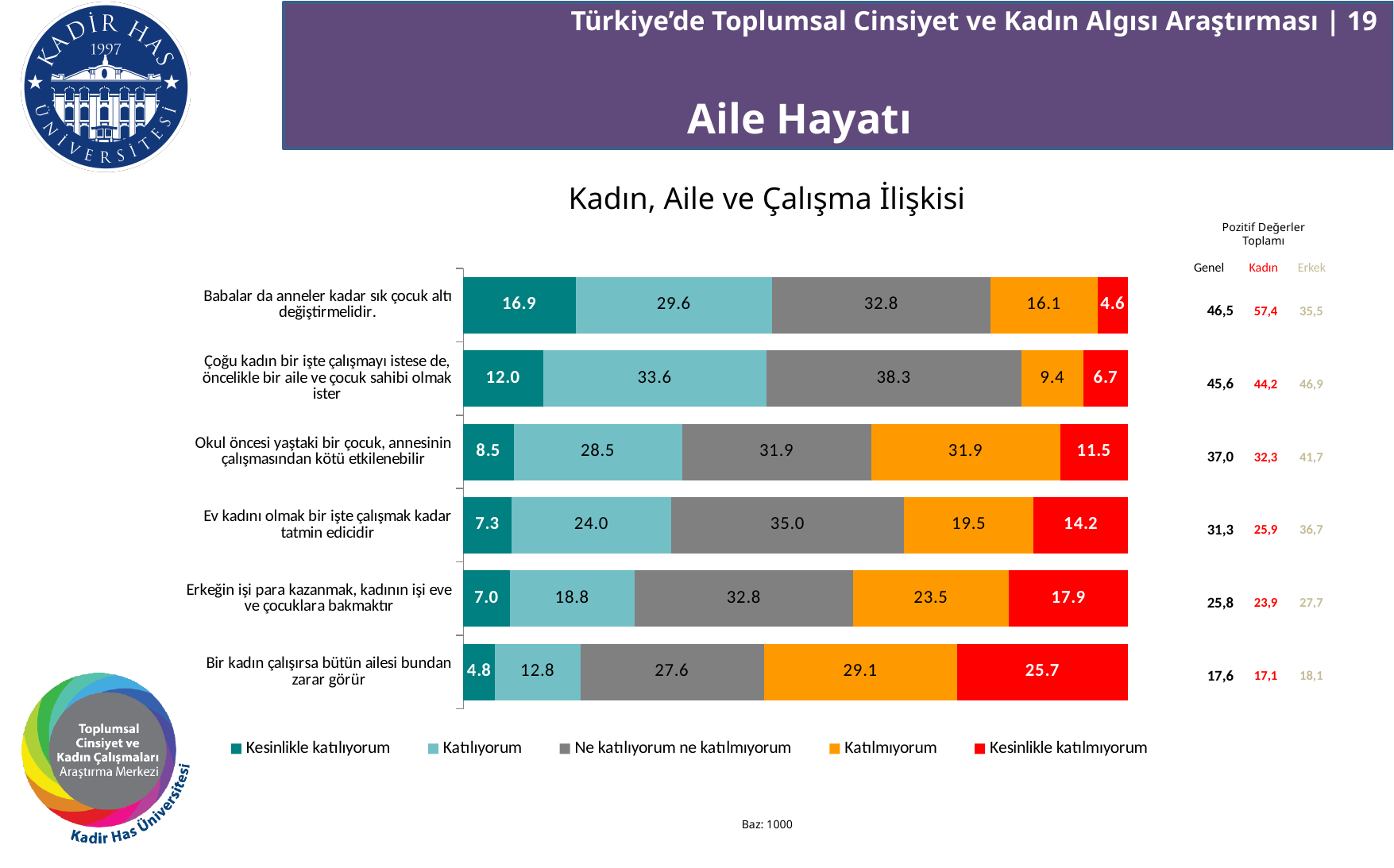
What is the 'Kesinlikle katılıyorum' value for 'Babalar da anneler kadar sık çocuk altı değiştirmelidir.'? 16.9 Which is larger: the 'Katılıyorum' value for 'Ev kadını olmak bir işte çalışmak kadar tatmin edicidir' or for 'Erkeğin işi para kazanmak, kadının işi eve ve çocuklara bakmaktır'? Ev kadını olmak bir işte çalışmak kadar tatmin edicidir Which statement has the highest 'Kesinlikle katılıyorum' value? Babalar da anneler kadar sık çocuk altı değiştirmelidir. What kind of chart is shown on the slide? Stacked bar chart What is the 'Ne katılıyorum ne katılmıyorum' value for 'Çoğu kadın bir işte çalışmayı istese de, öncelikle bir aile ve çocuk sahibi olmak ister'? 38.3 What is the total of the stacked bar for 'Bir kadın çalışırsa bütün ailesi bundan zarar görür'? 100.0 What colour represents the 'Kesinlikle katılmıyorum' series in the chart? Red How many statements (categories) are plotted in the chart? 6 What is the difference between the 'Katılmıyorum' values for 'Bir kadın çalışırsa bütün ailesi bundan zarar görür' and 'Babalar da anneler kadar sık çocuk altı değiştirmelidir.'? 13.0 What is the 'Kesinlikle katılmıyorum' value for 'Bir kadın çalışırsa bütün ailesi bundan zarar görür'? 25.7 How many series does the legend list? 5 Which statement has the lowest 'Kesinlikle katılmıyorum' value? Babalar da anneler kadar sık çocuk altı değiştirmelidir.